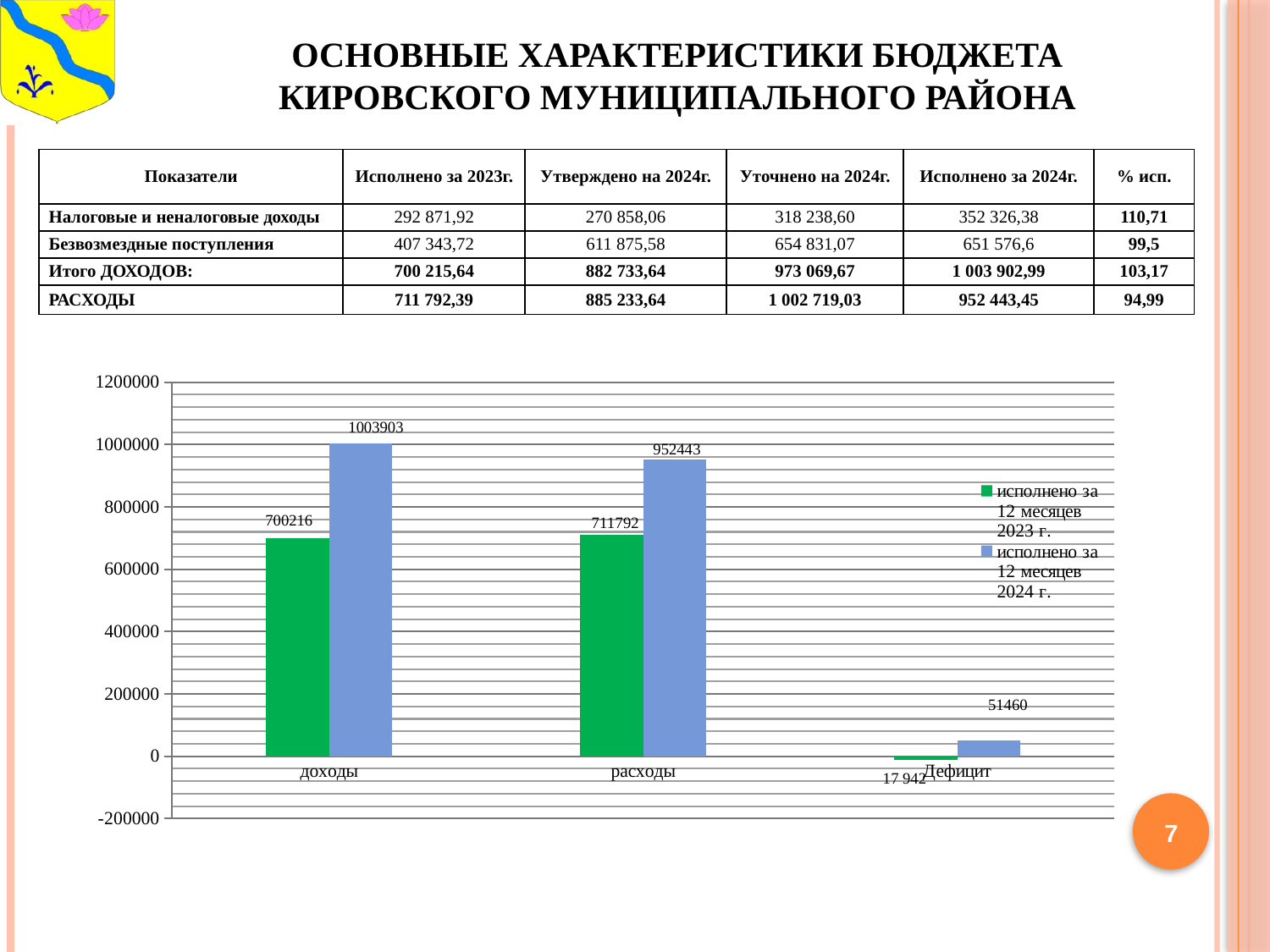
How many series does the chart legend list? 2 In the chart, what is the value for Дефицит for the series 'исполнено за 12 месяцев 2024 г.'? 51460 In the chart, what is the difference between доходы in 2024 (1003903) and доходы in 2023 (700216)? 303687 In the chart, which category has the highest value for the series 'исполнено за 12 месяцев 2024 г.'? доходы In the chart, what is the value for доходы for the series 'исполнено за 12 месяцев 2023 г.'? 700216 In the chart, is the value for Дефицит in 2024 greater or less than 200000? less What type of chart is shown on the slide? bar chart In the chart, what is the value for расходы for the series 'исполнено за 12 месяцев 2023 г.'? 711792 In the chart, what is the difference between расходы in 2024 (952443) and расходы in 2023 (711792)? 240651 In the chart, which is larger for 2024: доходы or расходы? доходы In the chart, what is the value for доходы for the series 'исполнено за 12 месяцев 2024 г.'? 1003903 How many categories are shown on the x axis of the chart? 3